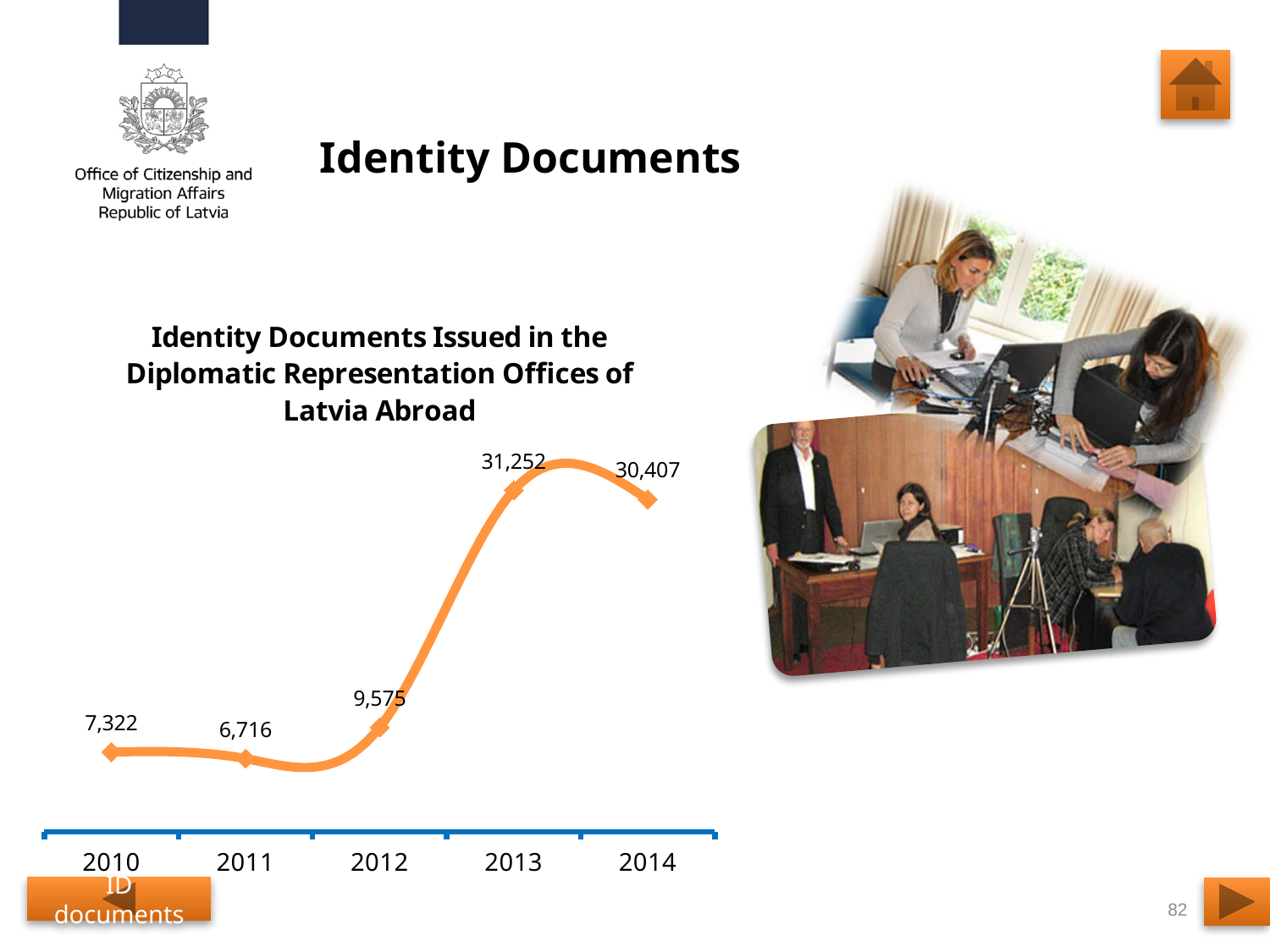
How many years are plotted on the chart? 5 What value is shown for 2010? 7,322 What value is shown for 2012? 9,575 What value is shown for 2014? 30,407 What is the difference between the values for 2013 and 2014? 845 Which year has the highest value? 2013 What value is shown for 2013? 31,252 What is the title of the chart? Identity Documents Issued in the Diplomatic Representation Offices of Latvia Abroad Which year has the lowest value? 2011 What is the difference between the values for 2012 and 2011? 2,859 What kind of chart is shown? line chart Which is larger, the value for 2010 or the value for 2011? 2010